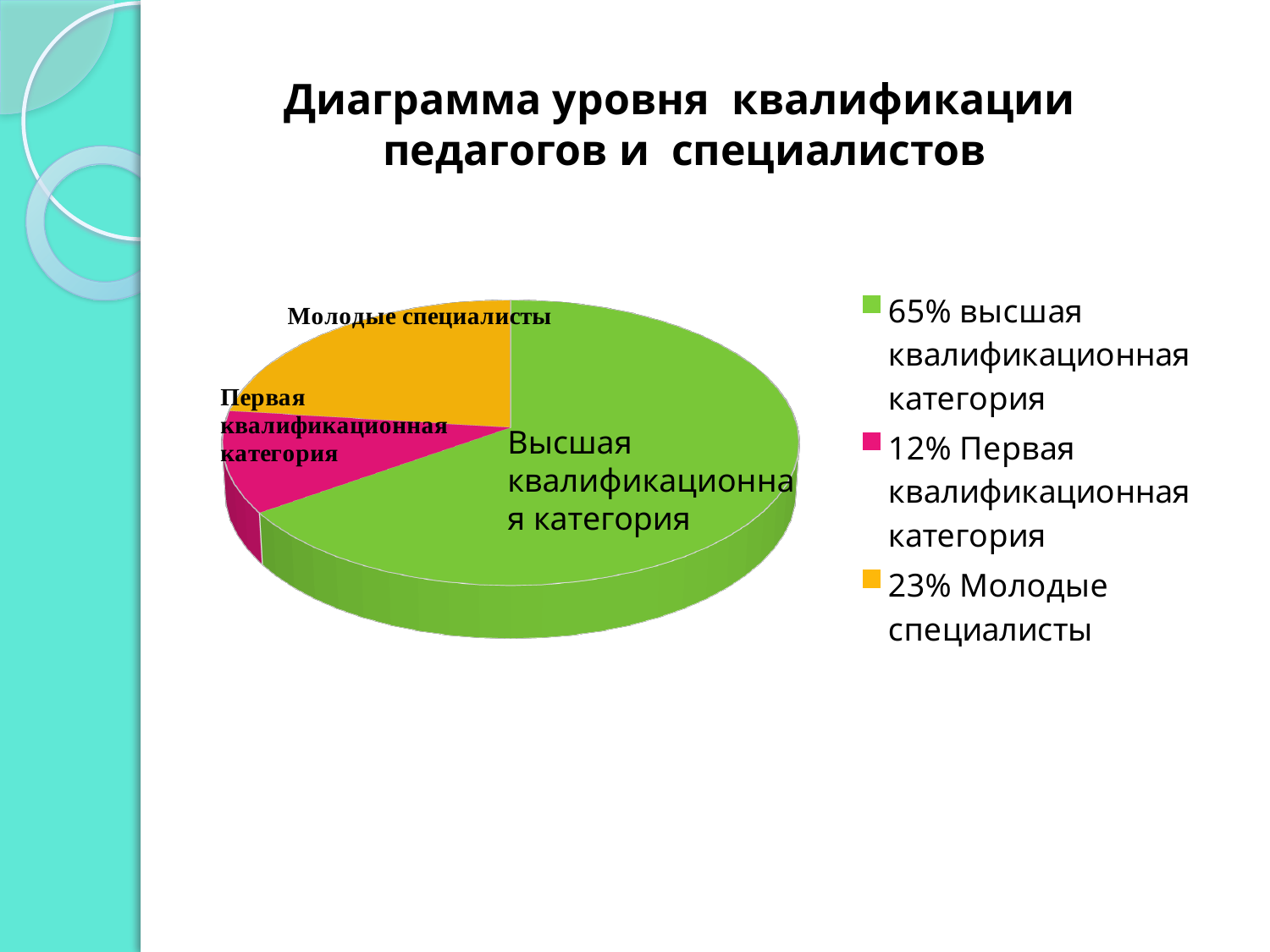
How many slices does the pie chart have? 3 Which category has the smallest slice of the pie? Первая квалификационная категория What is the title of the slide containing the chart? Диаграмма уровня квалификации педагогов и специалистов What colour is the slice for Молодые специалисты? orange Which category has the largest slice of the pie? Высшая квалификационная категория What kind of chart is shown on the slide? pie chart What share of the pie is Высшая квалификационная категория? 65% What share of the pie is Первая квалификационная категория? 12% Which is larger: Молодые специалисты or Первая квалификационная категория? Молодые специалисты What is the difference in percentage points between Молодые специалисты and Первая квалификационная категория? 11 What share of the pie is Молодые специалисты? 23% What is the difference in percentage points between Высшая квалификационная категория and Молодые специалисты? 42